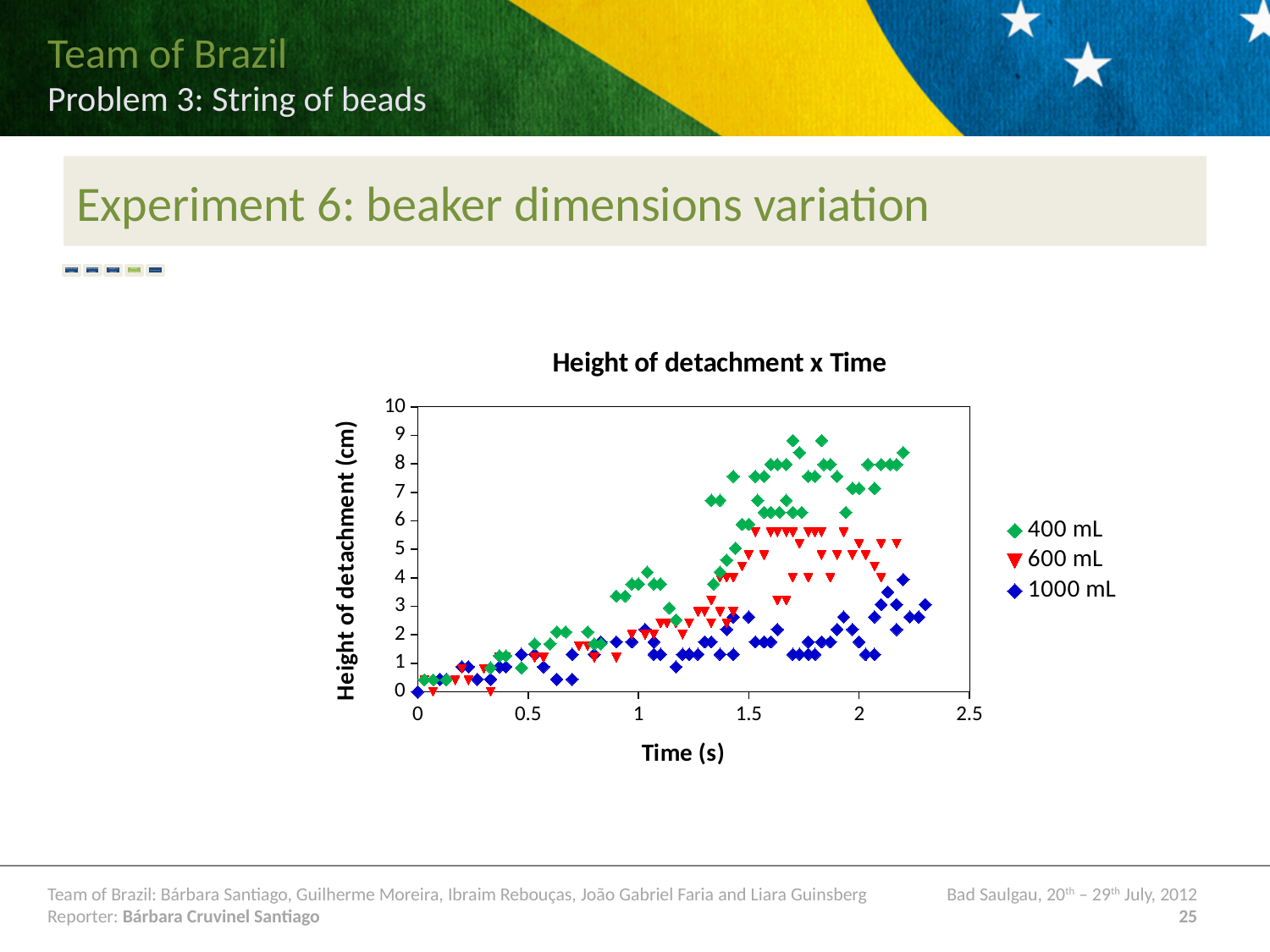
Is the highest value for the 400 mL series greater or less than 8 cm? greater What are the three series named in the legend? 400 mL, 600 mL, 1000 mL At around 1.8 s, which series has the larger height of detachment, 400 mL or 1000 mL? 400 mL Is the highest value for the 600 mL series greater or less than 5 cm? greater Does the height of detachment for the 400 mL series generally rise or fall as time increases? Rise Is the highest value for the 1000 mL series greater or less than 5 cm? less What kind of chart is shown on the slide? Scatter chart What is the title of the chart? Height of detachment x Time Which series stays at the lowest heights of detachment overall? 1000 mL How many series does the legend list? 3 What is the maximum value shown on the vertical axis? 10 Which series reaches the highest height of detachment? 400 mL